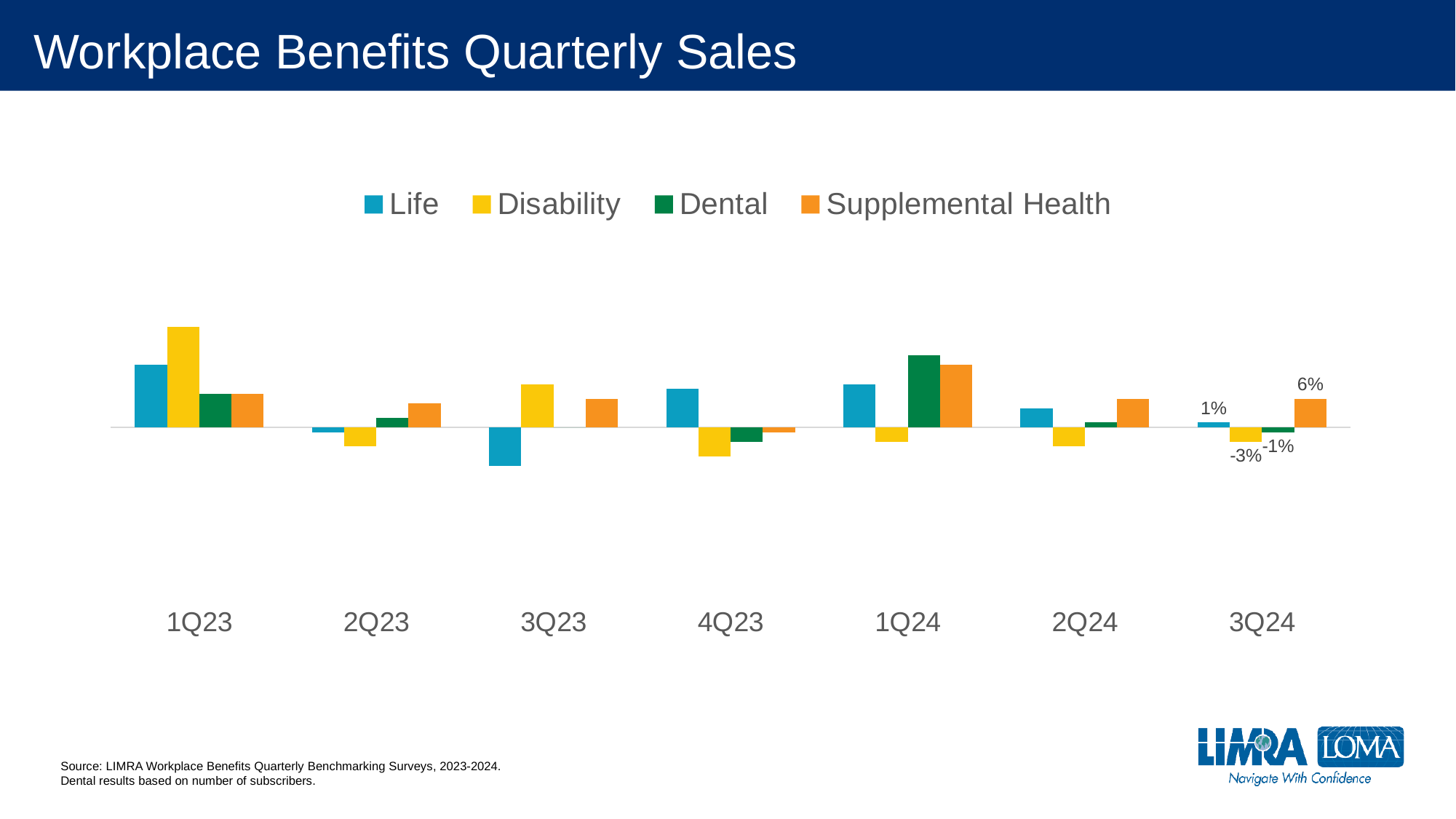
Does the Life series rise or fall from 1Q23 to 3Q23? Fall Which series has the lowest value in 3Q24? Disability What is the value for Dental in 3Q24? -1% In 3Q24, which is larger: the value for Life or the value for Dental? Life What kind of chart is shown on the slide? Bar chart What is the value for Life in 3Q24? 1% What is the value for Disability in 3Q24? -3% How many series does the legend list? 4 Which series has the highest value in 3Q24? Supplemental Health What is the difference between the Supplemental Health and Life values in 3Q24? 5 percentage points What is the value for Supplemental Health in 3Q24? 6% How many quarters are shown on the x axis? 7